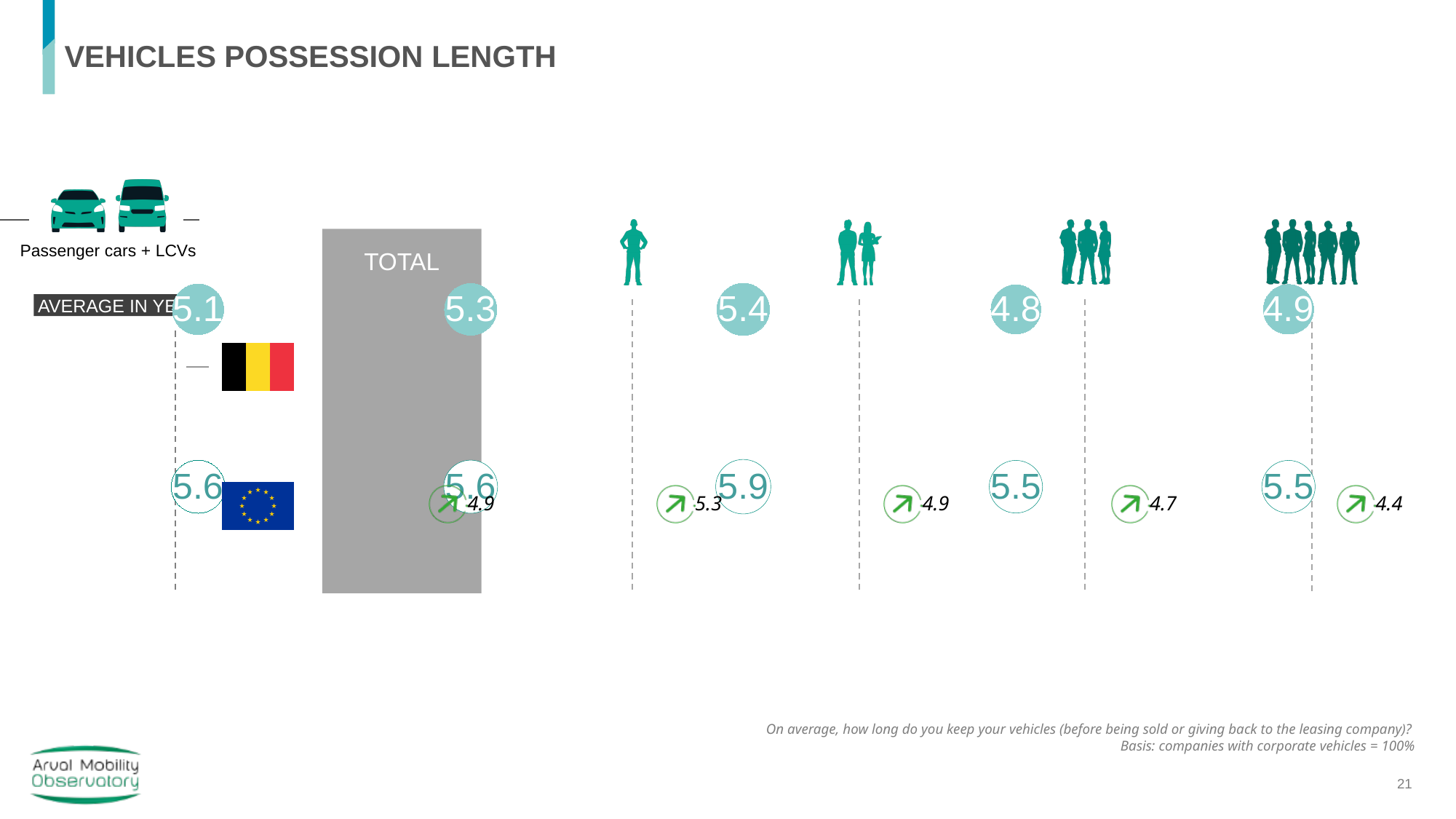
What is the title of the chart on the slide? VEHICLES POSSESSION LENGTH What is the lowest value shown next to the green arrow icons? 4.4 In the TOTAL column, what is the value shown for the EU (bottom row)? 5.6 What is the highest value shown in the EU (bottom) row of circles? 5.9 In the TOTAL column, what is the difference between the EU value and the Belgium value? 0.3 How many values are shown next to green arrow icons on the slide? 5 What is the lowest value shown in the Belgium (top) row of circles? 4.8 Is the Belgium value in the TOTAL column greater or less than 5? greater What is the highest value shown in the Belgium (top) row of circles? 5.4 In the TOTAL column, which is larger: the Belgium value or the EU value? EU Which vehicle types does the chart cover, according to the label under the vehicle icons? Passenger cars + LCVs In the TOTAL column, what is the value shown for Belgium (top row)? 5.3